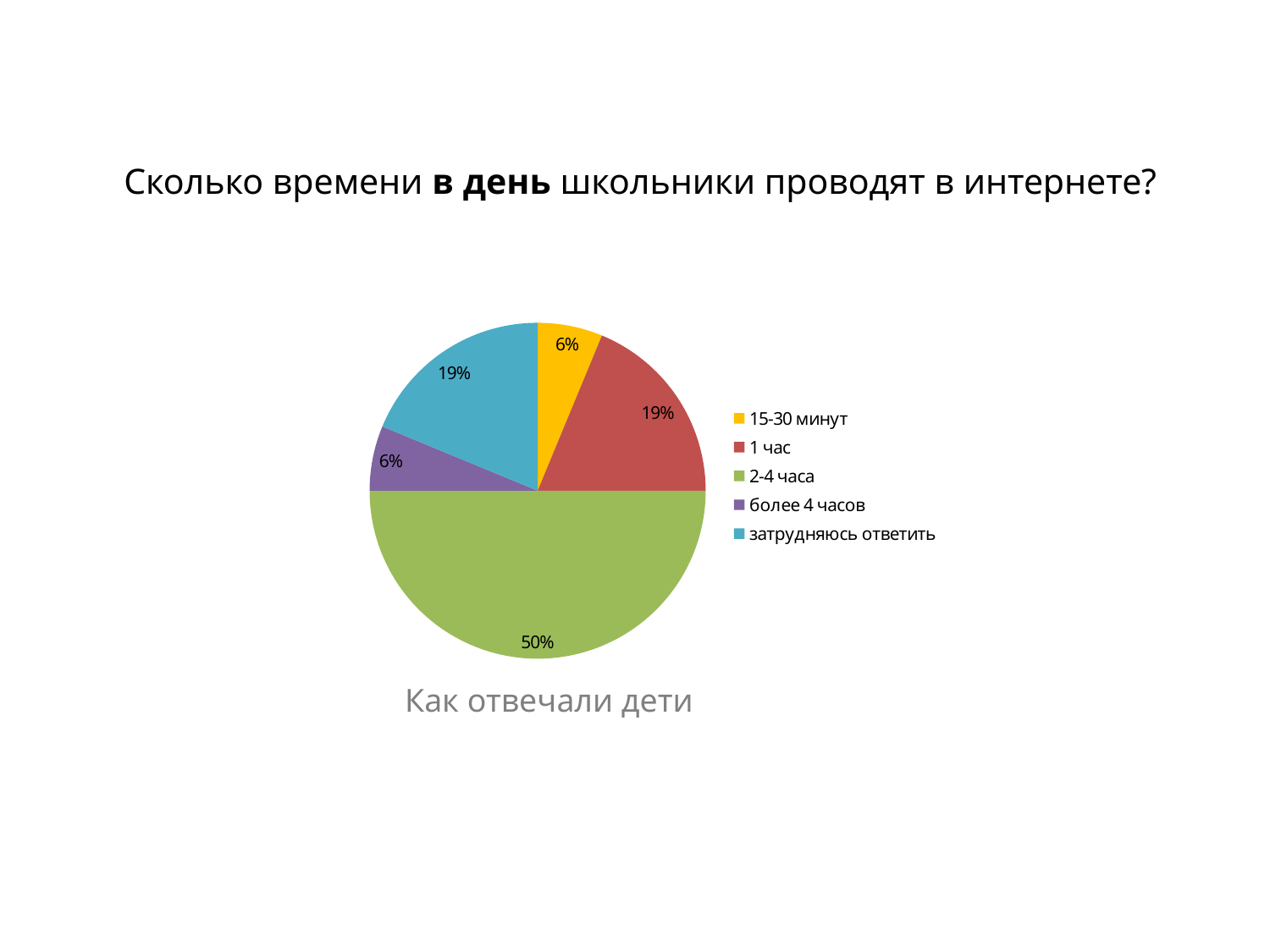
Which colour represents "затрудняюсь ответить" in the legend? blue What kind of chart is shown on the slide? pie chart What share of the pie is the slice for "2-4 часа"? 50% What is the difference between the values for "2-4 часа" and "1 час"? 31% What is the value for "более 4 часов"? 6% What is the value for "затрудняюсь ответить"? 19% What is the value for "15-30 минут"? 6% How many slices does the pie chart have? 5 Which is larger, the slice for "1 час" or the slice for "более 4 часов"? 1 час What is the chart's title? Как отвечали дети Which category has the largest slice? 2-4 часа What is the value for "1 час"? 19%